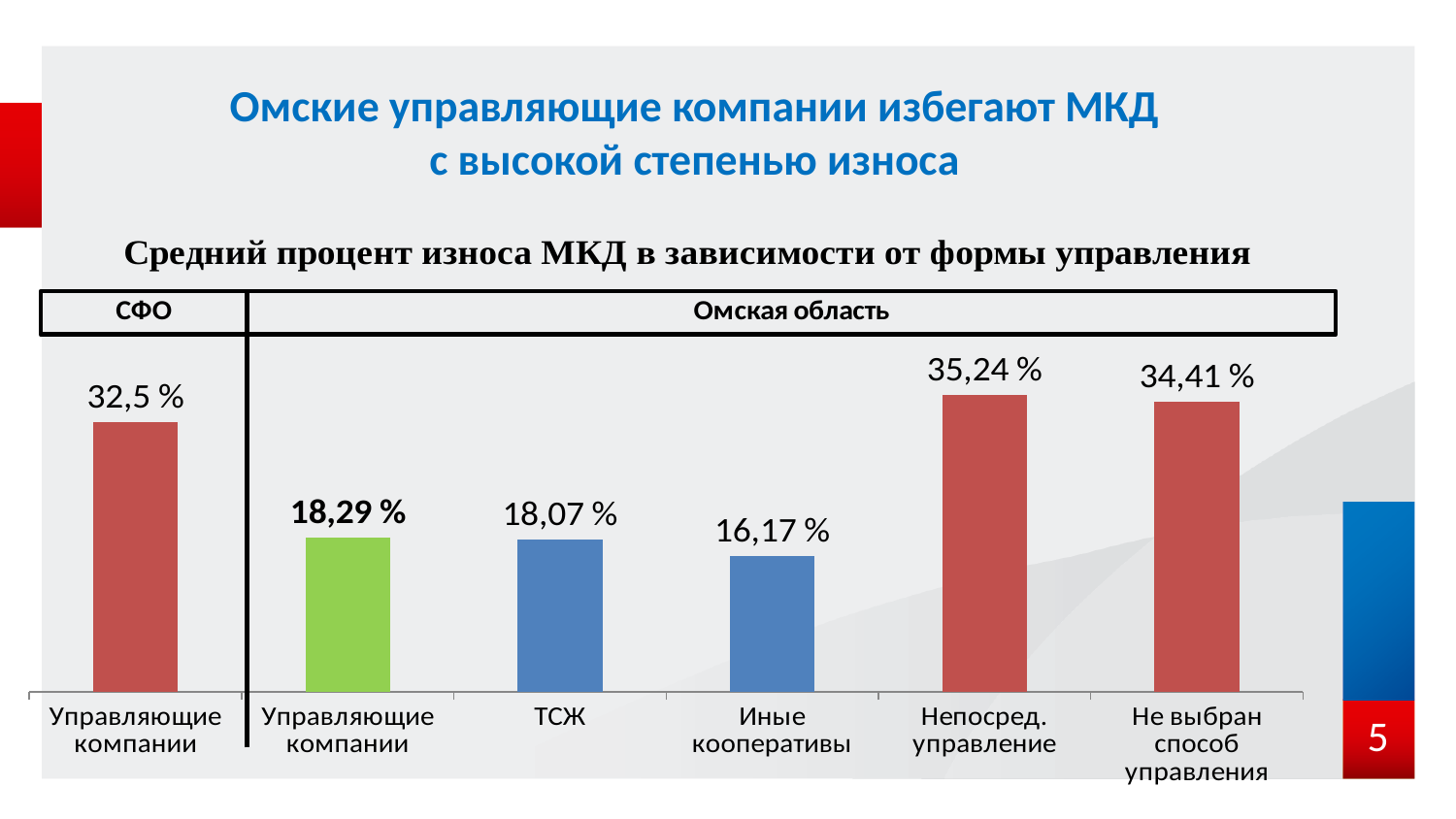
What is the value shown for ТСЖ? 18,07 % How many bars are plotted on the chart? 6 Which category has the lowest value on the chart? Иные кооперативы What is the difference between the values for Непосред. управление and Не выбран способ управления? 0,83 % What is the difference between Управляющие компании in СФО and Управляющие компании in Омская область? 14,21 % What is the value shown for Иные кооперативы? 16,17 % What kind of chart is shown on the slide? Bar chart Which category has the highest value on the chart? Непосред. управление What is the value shown for Непосред. управление? 35,24 % Which is larger: the value for ТСЖ or the value for Иные кооперативы? ТСЖ What is the average wear percentage for Управляющие компании in СФО? 32,5 % What is the value for Управляющие компании in Омская область? 18,29 %